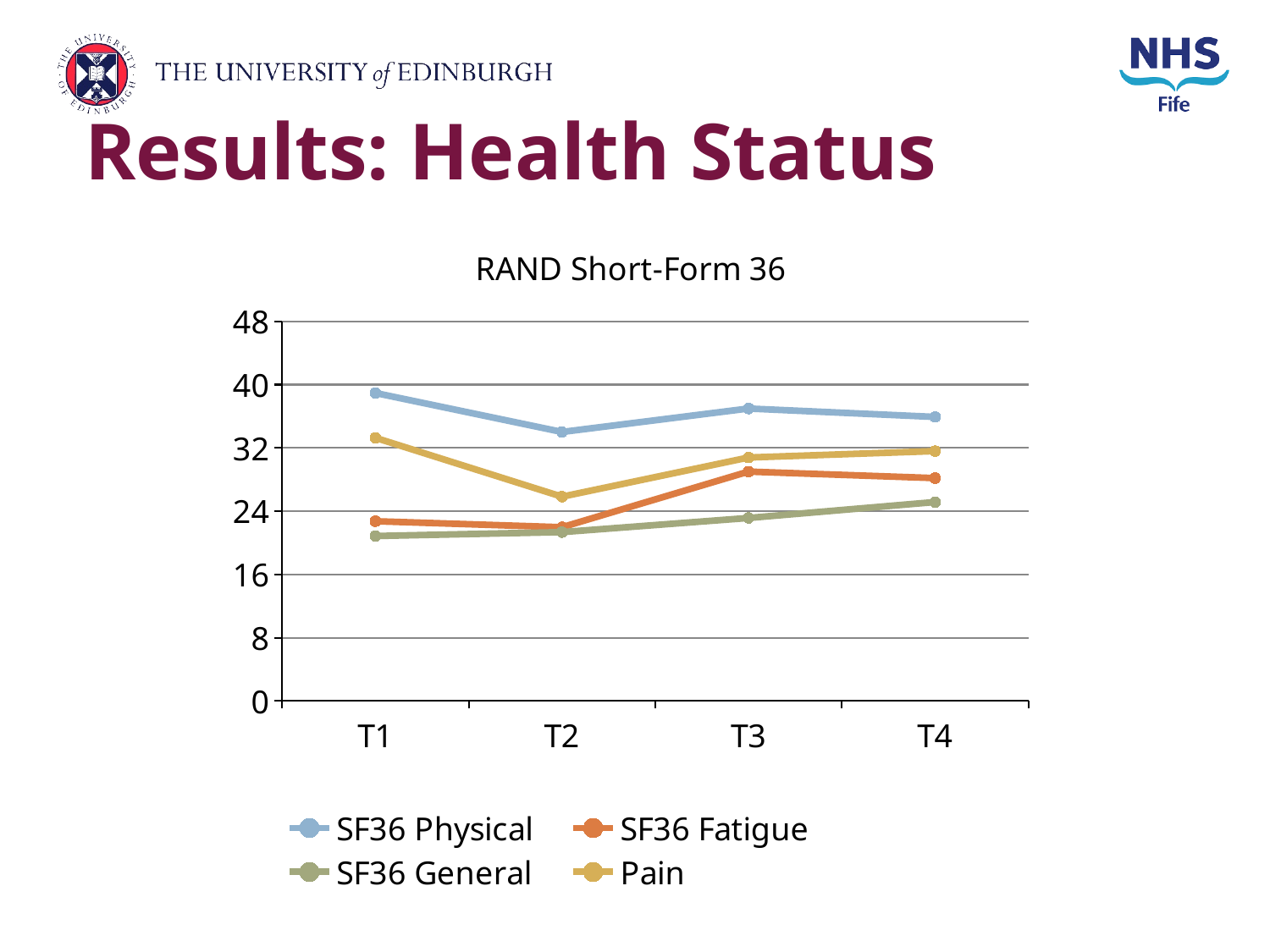
Is the value for SF36 General at T1 greater or less than 24? less Is the value for SF36 Physical at T2 greater or less than 40? less Is the value for SF36 Fatigue at T3 greater or less than 24? greater Does the SF36 General series rise or fall from T1 to T4? Rise How many time points are shown on the x axis? 4 What kind of chart is shown on the slide? Line chart How many series does the legend list? 4 Which series has the highest value at T1? SF36 Physical What is the title of the chart? RAND Short-Form 36 Which series is shown in blue in the legend? SF36 Physical At T1, which is larger: Pain or SF36 Fatigue? Pain Which series has the lowest value at T4? SF36 General